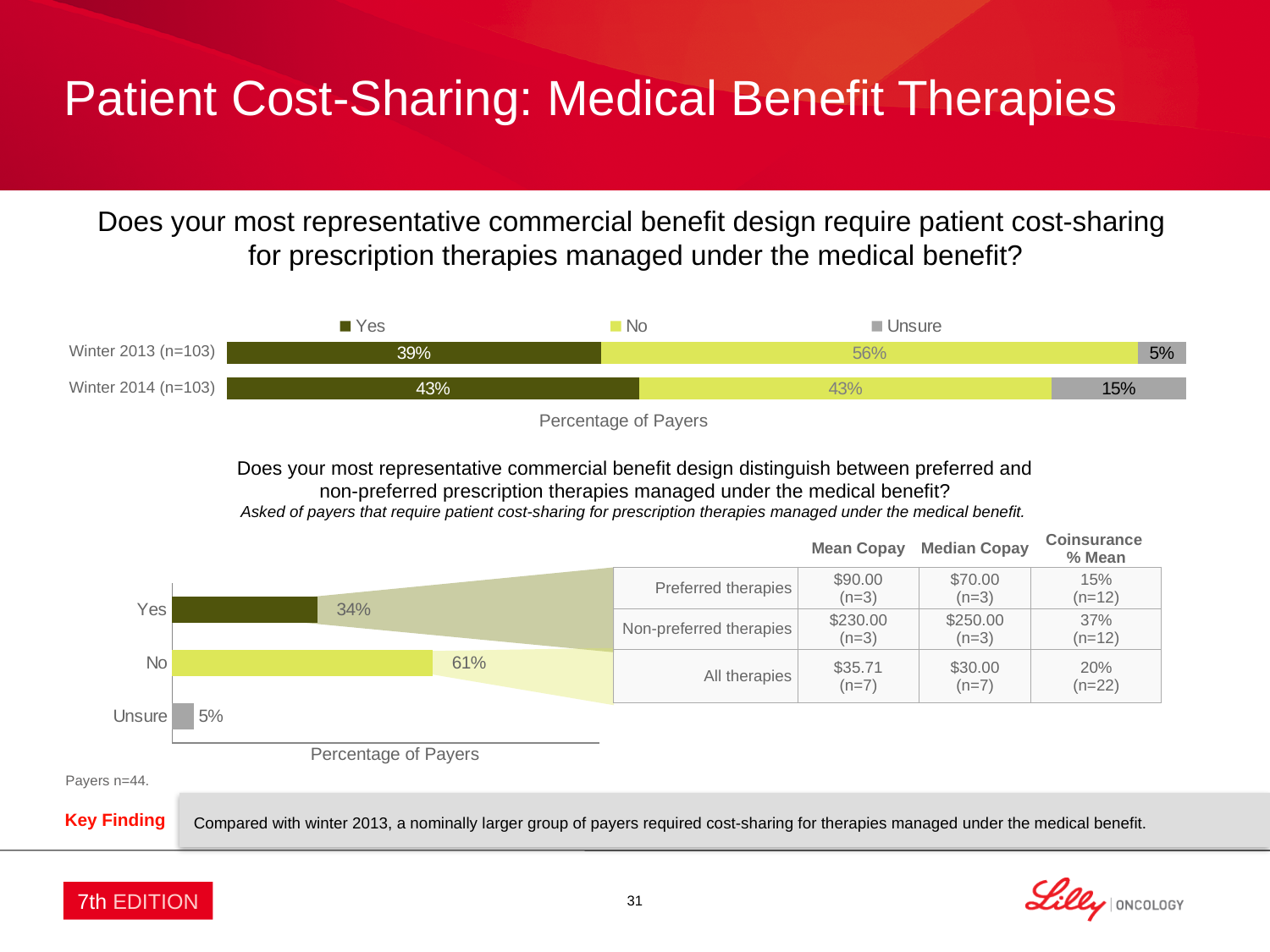
In the bottom chart, what is the difference between the No and Yes percentages? 27% In the top chart, what percentage of payers answered No in Winter 2013 (n=103)? 56% In the bottom chart, which response has the highest percentage of payers? No In the top chart, which year has the larger Yes share, Winter 2013 or Winter 2014? Winter 2014 In the bottom chart, which response has the lowest percentage of payers? Unsure In the top chart, what is the difference in the Unsure share between Winter 2014 and Winter 2013? 10% In the top chart, what percentage of payers answered Yes in Winter 2014 (n=103)? 43% In the top chart, what is the total of the Winter 2014 (n=103) stacked bar? 101% In the top chart, what percentage of payers answered Unsure in Winter 2013 (n=103)? 5% In the top chart, how many series does the legend list? 3 In the bottom chart, what percentage of payers answered No? 61% What kind of chart is the bottom chart? Bar chart